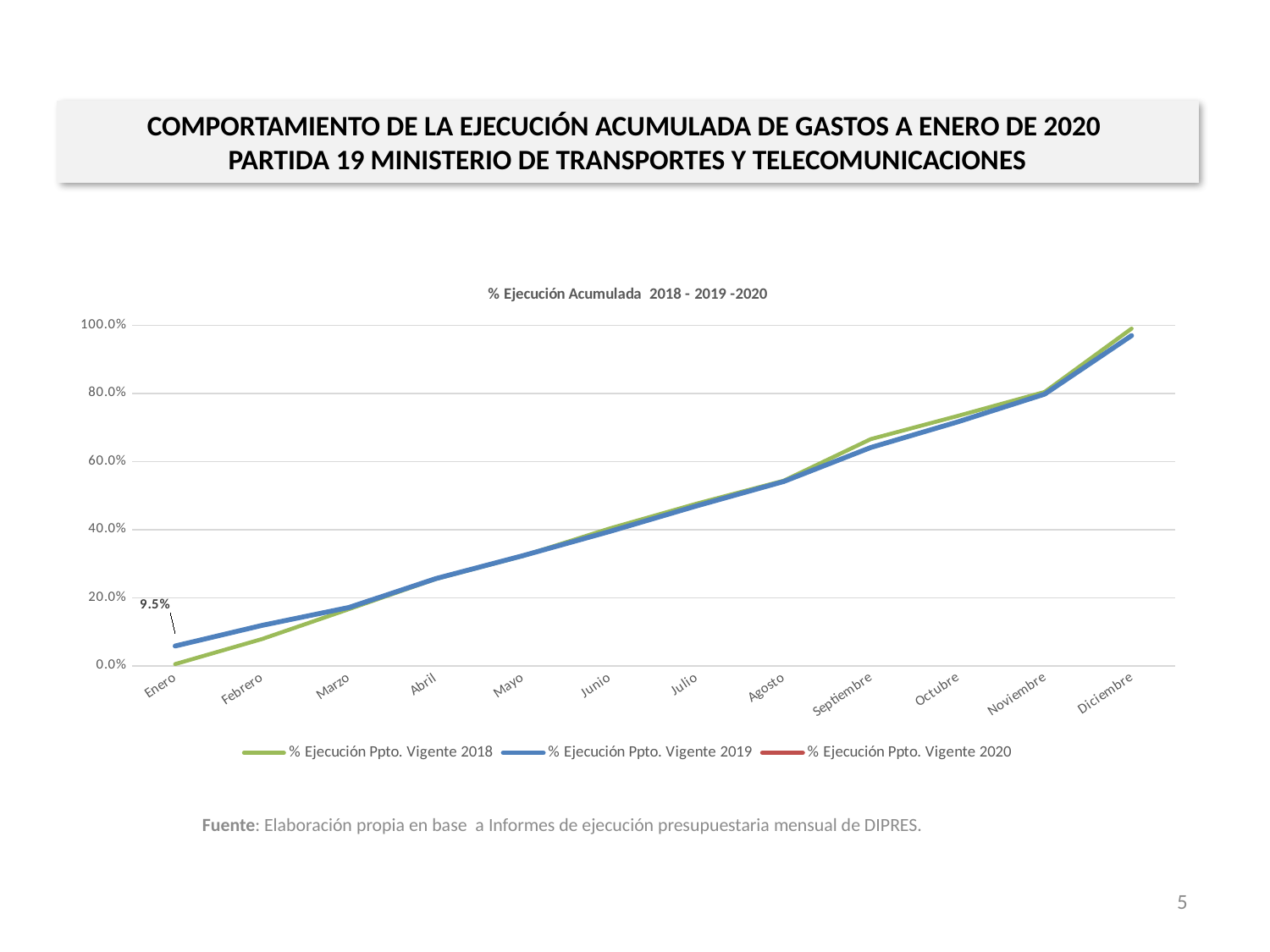
In which month is the value for % Ejecución Ppto. Vigente 2019 highest? Diciembre In which month is the value for % Ejecución Ppto. Vigente 2018 lowest? Enero Do the values for % Ejecución Ppto. Vigente 2018 rise or fall from Enero to Diciembre? rise In Enero, which series has the larger value: % Ejecución Ppto. Vigente 2018 or % Ejecución Ppto. Vigente 2019? % Ejecución Ppto. Vigente 2019 How many series does the chart legend list? 3 What is the title of the chart? % Ejecución Acumulada 2018 - 2019 -2020 How many months are shown along the x axis of the chart? 12 Is the value for % Ejecución Ppto. Vigente 2019 in Enero greater or less than 20.0%? less Is the value for % Ejecución Ppto. Vigente 2018 in Diciembre greater or less than 80.0%? greater What value does the data label near Enero show? 9.5% Is the value for % Ejecución Ppto. Vigente 2018 in Septiembre greater or less than 60.0%? greater What kind of chart is shown on the slide? line chart